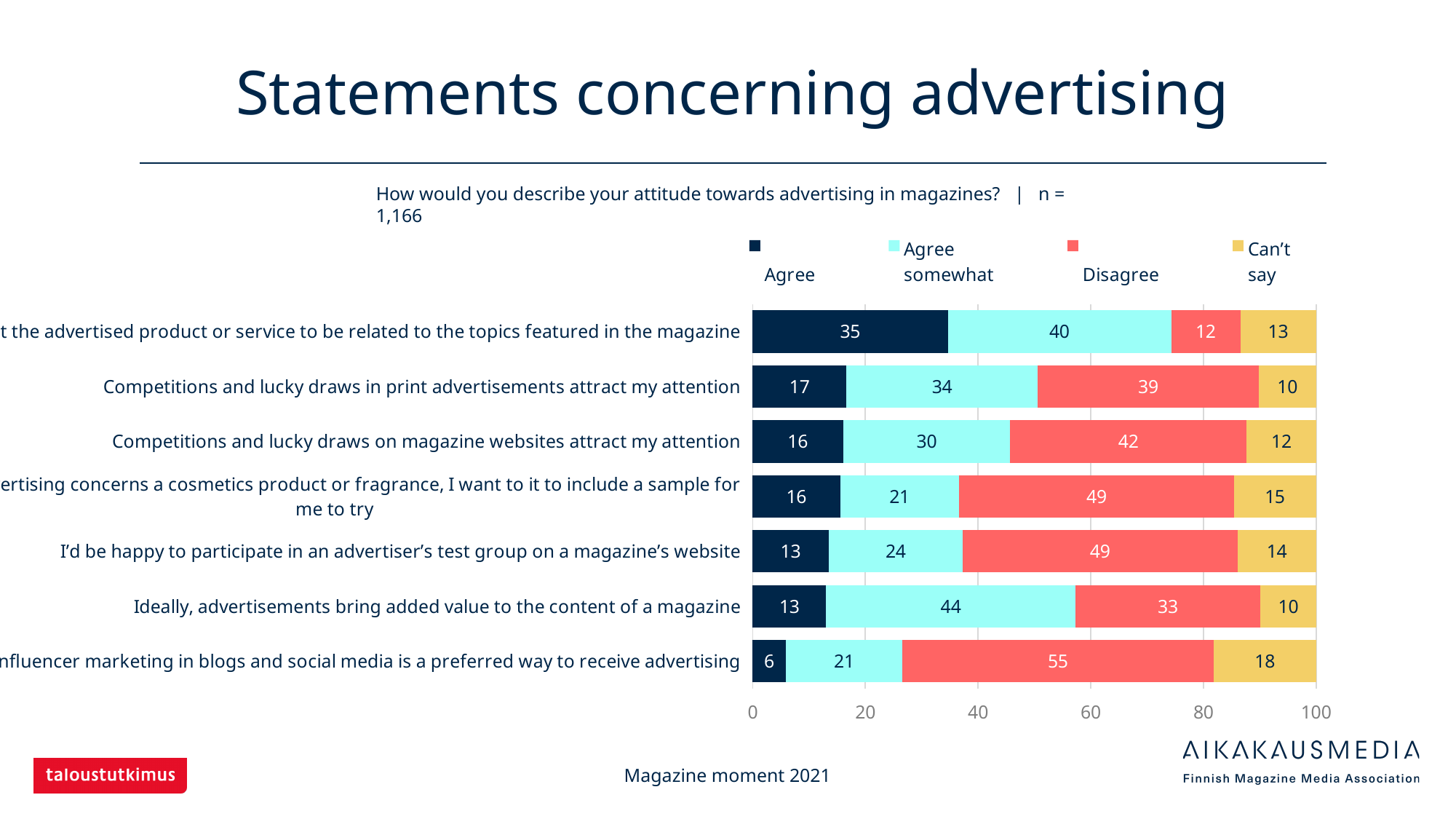
How many statements (bars) are plotted in the chart? 7 What is the 'Disagree' value for 'Competitions and lucky draws in print advertisements attract my attention'? 39 Which is larger: the 'Agree somewhat' value for 'Competitions and lucky draws in print advertisements attract my attention' or for 'Competitions and lucky draws on magazine websites attract my attention'? Competitions and lucky draws in print advertisements attract my attention What kind of chart is shown on the slide? Stacked bar chart What is the sample size (n) stated on the slide? 1,166 What is the difference between the 'Disagree' values for 'Competitions and lucky draws on magazine websites attract my attention' and 'Competitions and lucky draws in print advertisements attract my attention'? 3 What is the 'Agree' value for 'I'd be happy to participate in an advertiser's test group on a magazine's website'? 13 What is the 'Can't say' value for 'Competitions and lucky draws on magazine websites attract my attention'? 12 Which statement has the highest 'Agree' value? The top bar (the advertised product or service to be related to the topics featured in the magazine) How many series does the legend list? 4 What is the 'Agree somewhat' value for 'Ideally, advertisements bring added value to the content of a magazine'? 44 Which statement has the lowest 'Agree' value? The bottom bar (influencer marketing in blogs and social media is a preferred way to receive advertising)